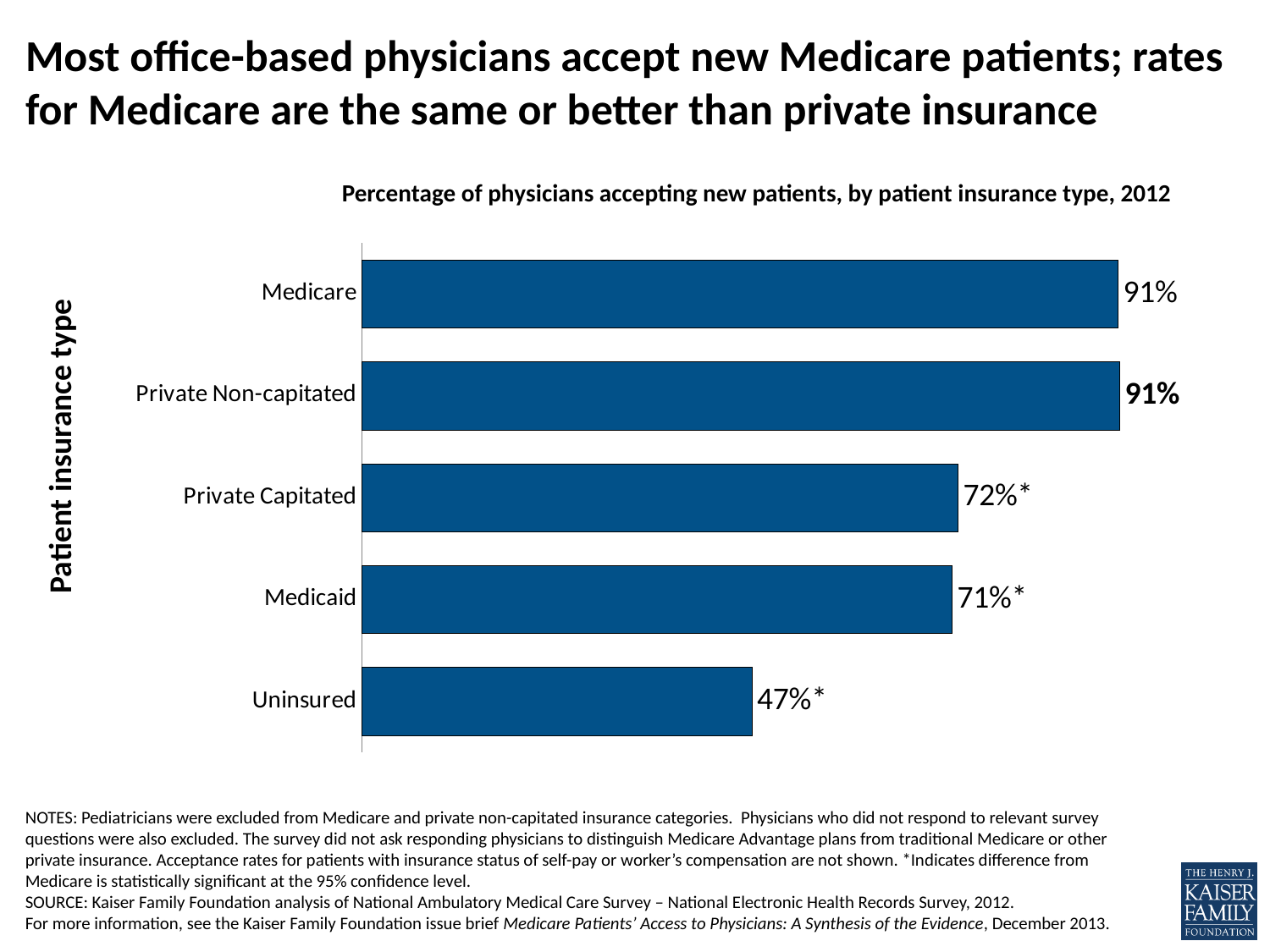
What kind of chart is shown on the slide? Bar chart What is the difference in percentage points between the Medicare and Medicaid values? 20 percentage points What percentage of physicians accept new Medicaid patients? 71% What is the value shown for Uninsured patients? 47% What is the title of the chart? Percentage of physicians accepting new patients, by patient insurance type, 2012 What is the value shown for Private Capitated? 72% What is the value shown for Private Non-capitated? 91% How many patient insurance types are shown in the chart? 5 What percentage of physicians accept new Medicare patients? 91% Which patient insurance type has the lowest acceptance rate? Uninsured What is the difference in percentage points between the Medicare and Uninsured values? 44 percentage points Which is larger, the value for Medicaid or the value for Uninsured? Medicaid